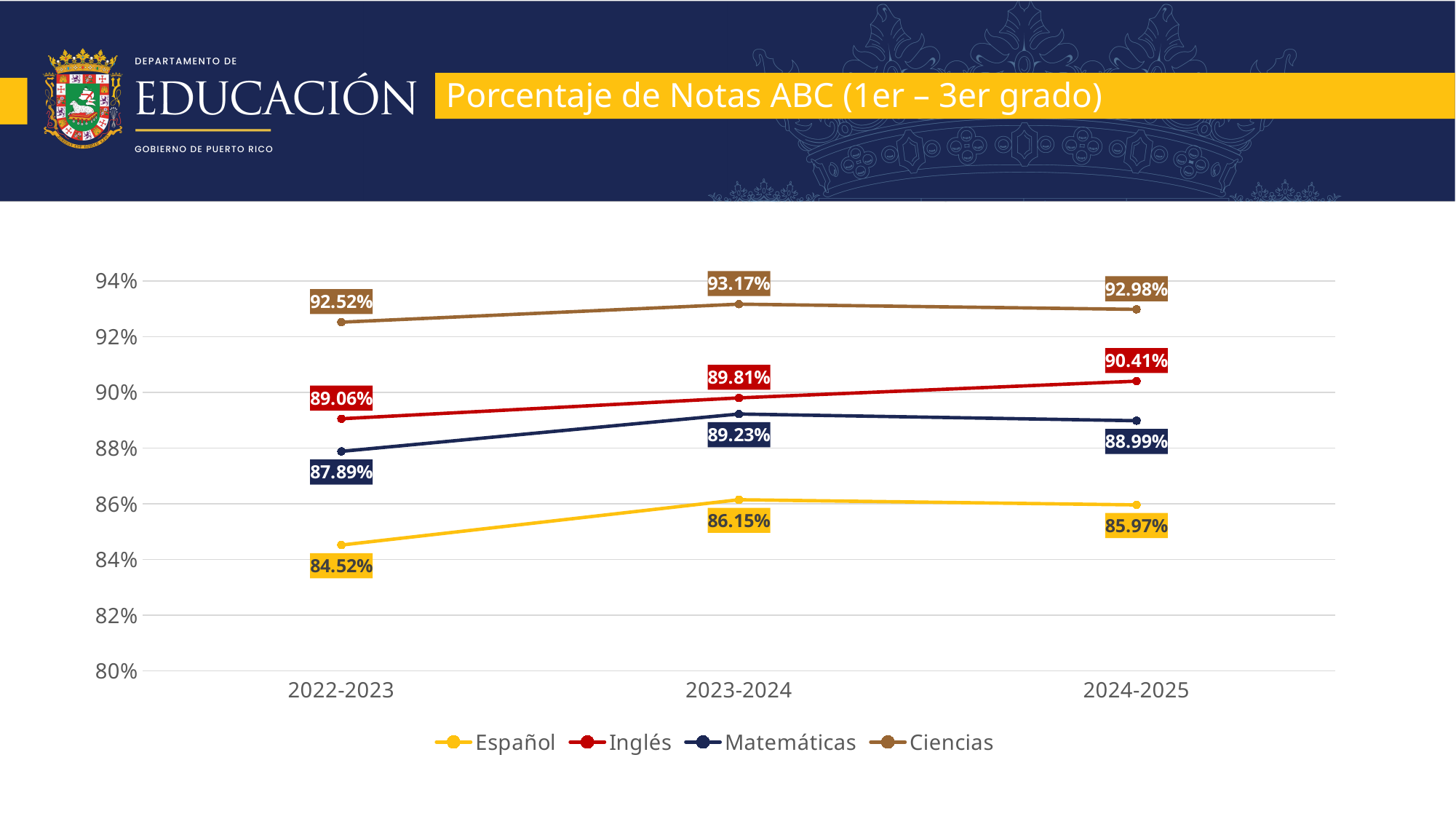
Which is larger in 2023-2024, Inglés or Matemáticas? Inglés What kind of chart is shown on the slide? Line chart Which series has the highest value in 2024-2025? Ciencias What is the value for Matemáticas in 2024-2025? 88.99% What is the value for Español in 2022-2023? 84.52% Does the Inglés series rise or fall from 2022-2023 to 2024-2025? Rise What is the difference between the Inglés values for 2024-2025 and 2022-2023? 1.35% How many school years are shown on the x axis? 3 Which series has the lowest value in 2022-2023? Español What is the value for Ciencias in 2023-2024? 93.17% What is the value for Inglés in 2023-2024? 89.81% How many series does the legend list? 4